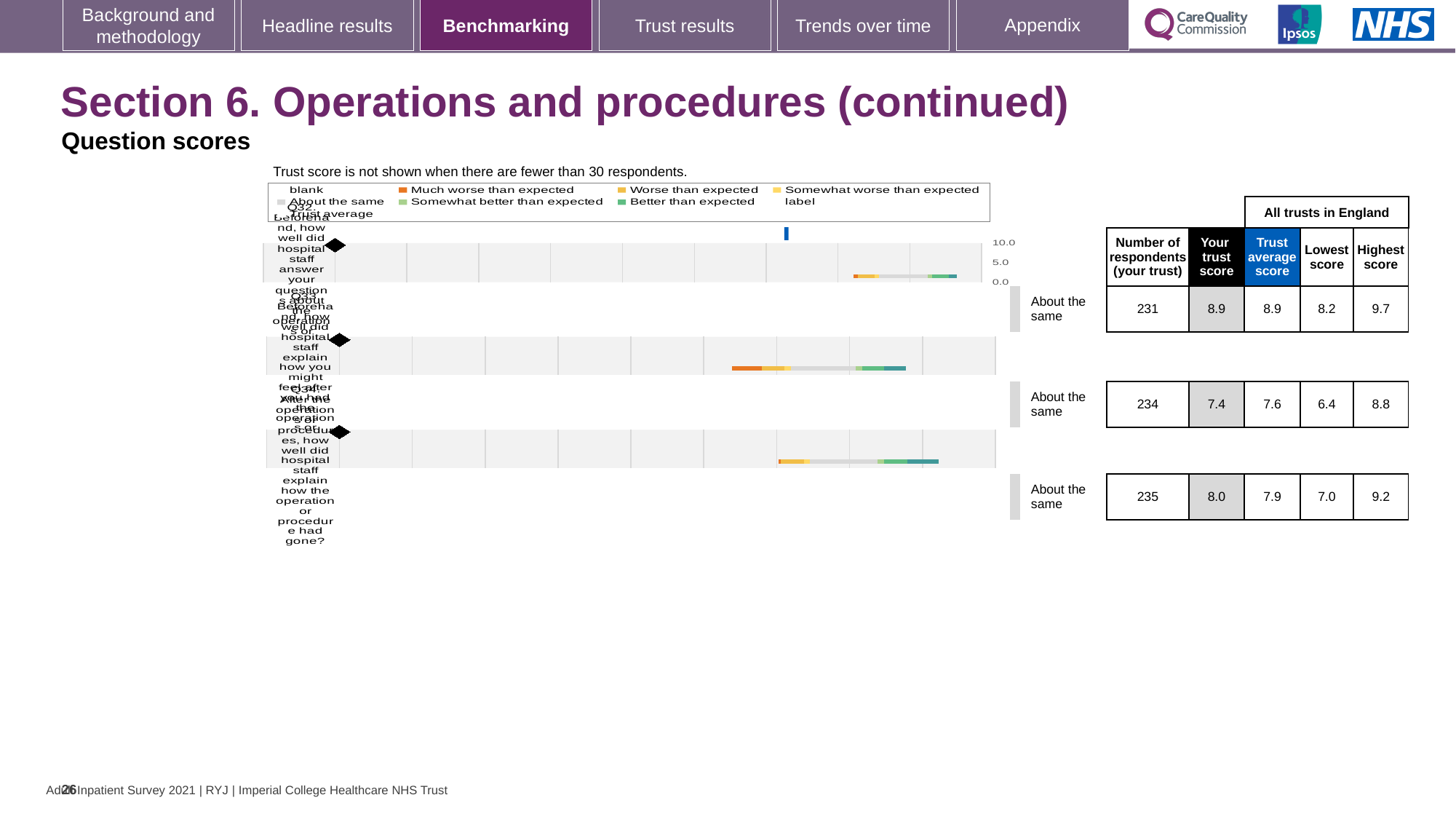
What is the 'Highest score' for the second question row? 8.8 Which question row has the lowest 'Your trust score'? The second row, 7.4 For the third (bottom) question row, which is larger: 'Your trust score' or 'Trust average score'? Your trust score (8.0) For the first (top) question row, what is the difference between the 'Highest score' and the 'Lowest score'? 1.5 In the table next to the chart, how many respondents are shown for the first (top) question row? 231 What is the 'Your trust score' value for the first (top) question row? 8.9 Which question row has the highest 'Your trust score'? The first (top) row, 8.9 For the second question row, what is the difference between the 'Trust average score' and 'Your trust score'? 0.2 What is the 'Lowest score' for the third (bottom) question row? 7.0 What is the 'Trust average score' for the second question row? 7.6 What benchmark category is shown beside each of the three question rows? About the same How many question rows are plotted on the chart? 3